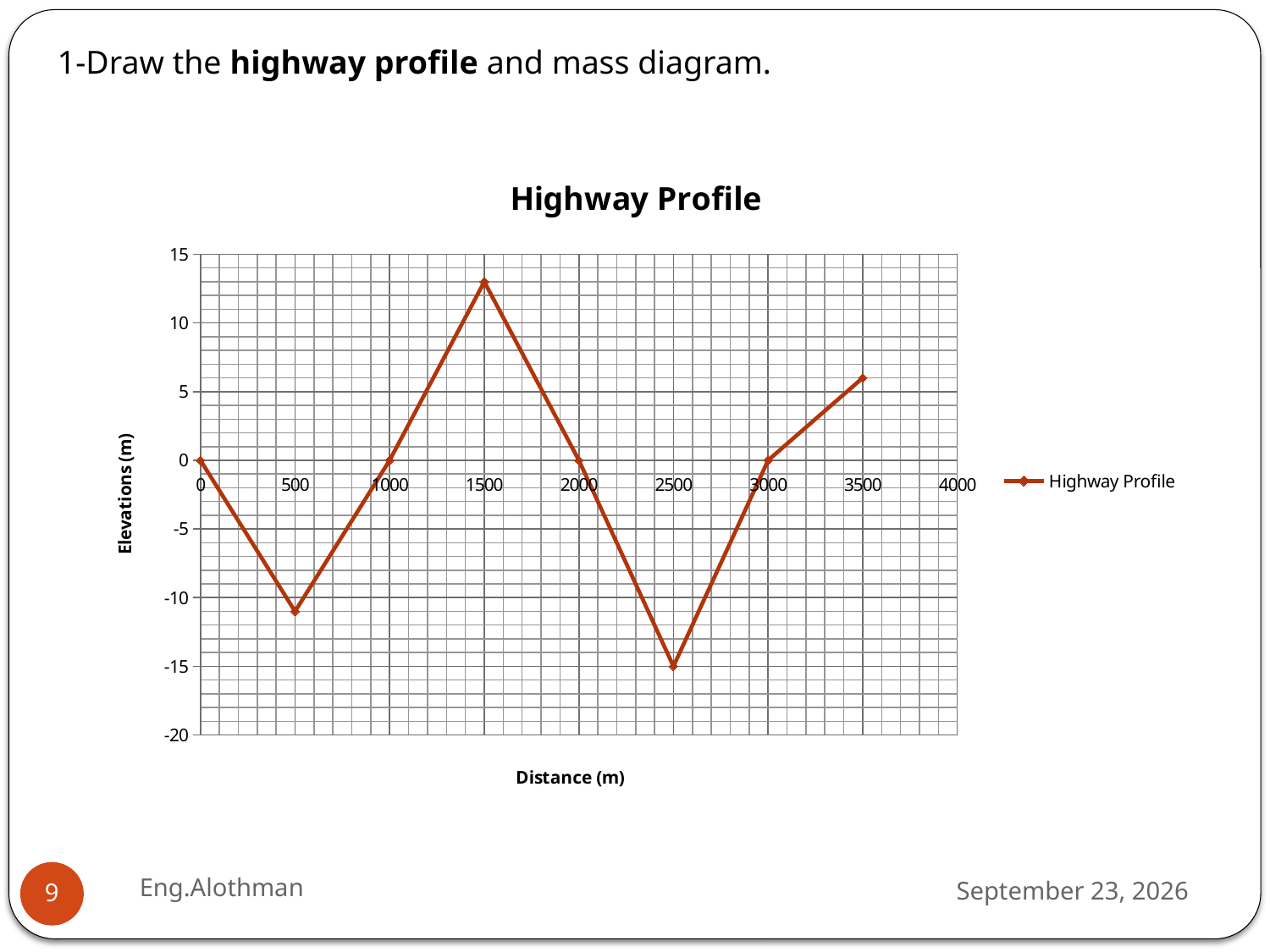
Is the elevation at 1500 m greater or less than 10? greater Which is larger, the elevation at 3500 m or the elevation at 500 m? 3500 m At which distance is the elevation lowest? 2500 What is the elevation at a distance of 2000 m? 0 How many data points are plotted on the Highway Profile line? 8 What is the title of the chart? Highway Profile At which distance is the elevation highest? 1500 How many series does the legend list? 1 What is the elevation at a distance of 0 m? 0 What is the elevation at a distance of 2500 m? -15 Is the elevation at 500 m greater or less than -10? less What kind of chart is shown on the slide? line chart